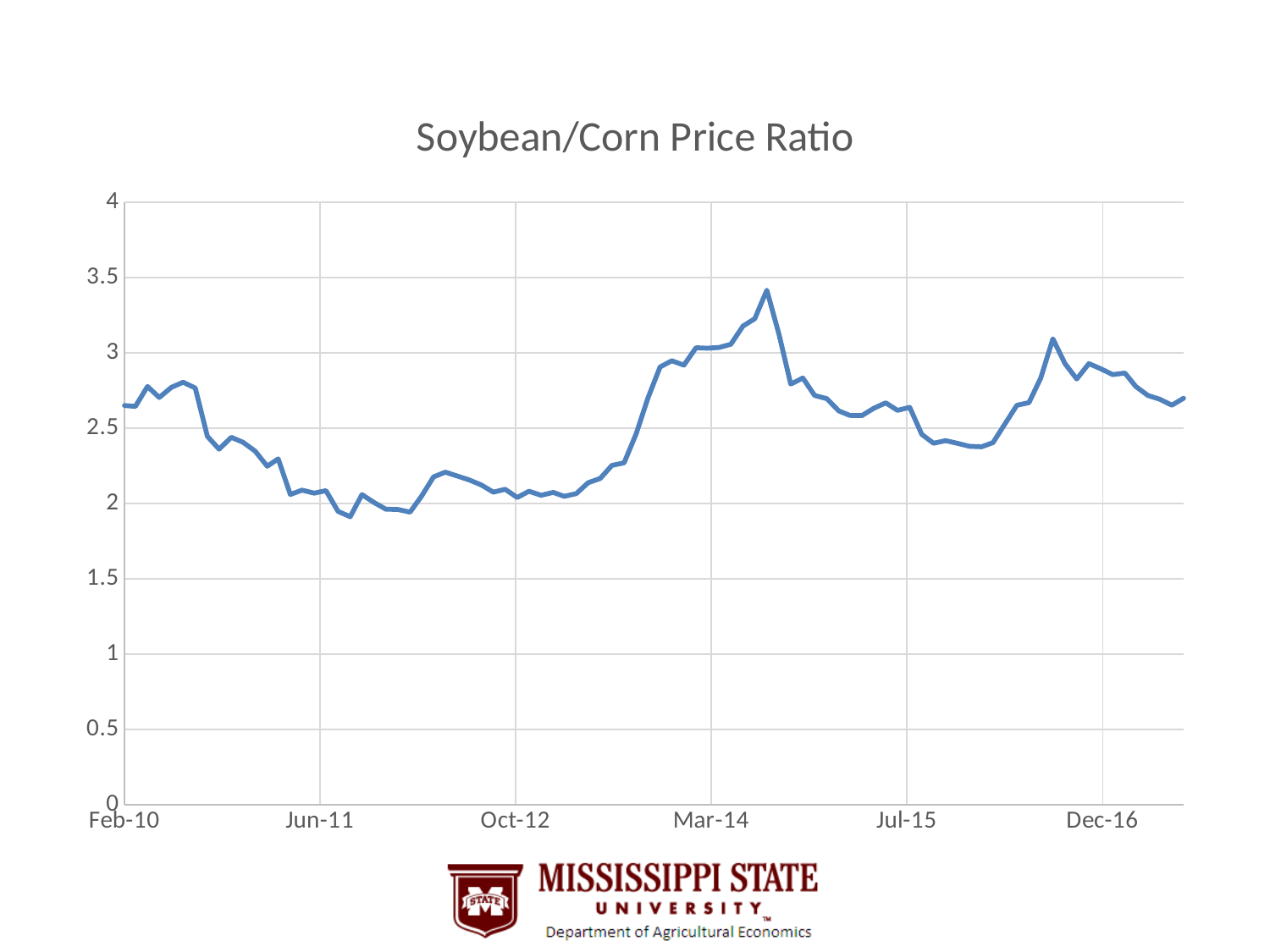
What type of chart is shown on the slide? line chart Is the value at Dec-16 greater or less than 3? less Which is larger, the value at Mar-14 or the value at Jun-11? Mar-14 Does the line rise or fall between Oct-12 and Mar-14? rise Is the value at Oct-12 greater or less than 2.5? less Is the value at Mar-14 greater or less than 2.5? greater What is the title of the chart? Soybean/Corn Price Ratio What is the highest value shown on the y axis? 4 How many date labels are shown on the x axis? 6 Does the line rise or fall between Feb-10 and Jun-11? fall